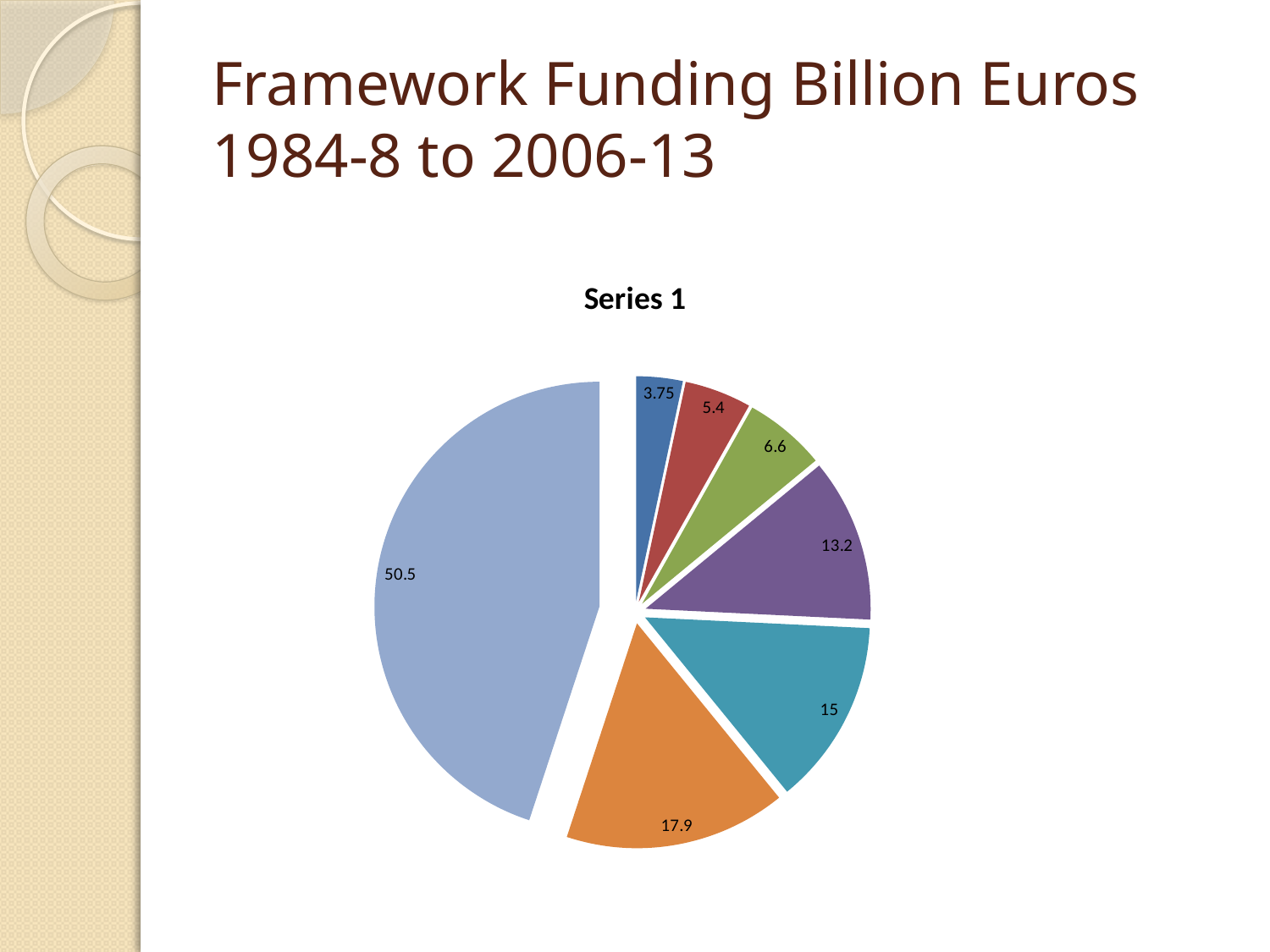
What is the value shown on the green slice of the pie chart? 6.6 What is the value of the smallest slice in the pie chart? 3.75 What is the difference between the largest slice (50.5) and the orange slice (17.9)? 32.6 How many slices does the pie chart have? 7 What is the difference between the teal slice (15) and the purple slice (13.2)? 1.8 Which is larger, the red slice or the dark blue slice? the red slice (5.4) What is the sum of all the slice values in the pie chart? 112.35 What kind of chart is shown on the slide? pie chart What is the value shown on the purple slice of the pie chart? 13.2 What is the title shown above the pie chart? Series 1 What is the value of the largest slice in the pie chart? 50.5 What is the value shown on the orange slice of the pie chart? 17.9